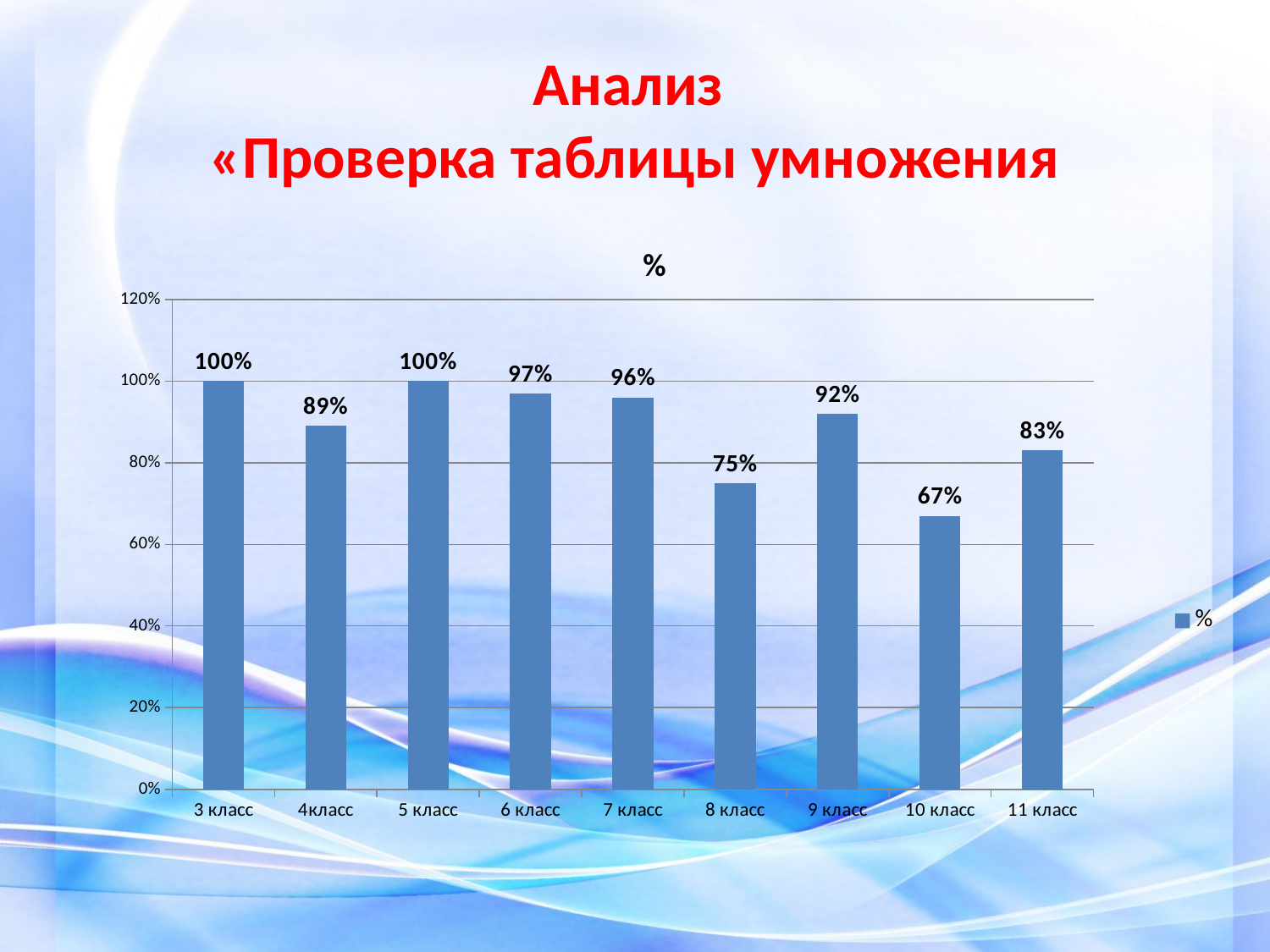
Which categories share the highest value of 100%? 3 класс and 5 класс What is the difference between the values for 9 класс and 10 класс? 25% Is the value for 10 класс greater or less than 80%? less Which category has the lowest value? 10 класс What kind of chart is shown on the slide? bar chart What is the value for 11 класс? 83% How many categories are shown on the x axis? 9 Which is larger, the value for 6 класс or the value for 7 класс? 6 класс What is the value for 8 класс? 75% What is the value for 4класс? 89% How many series does the legend list? 1 What is the title of the chart? %